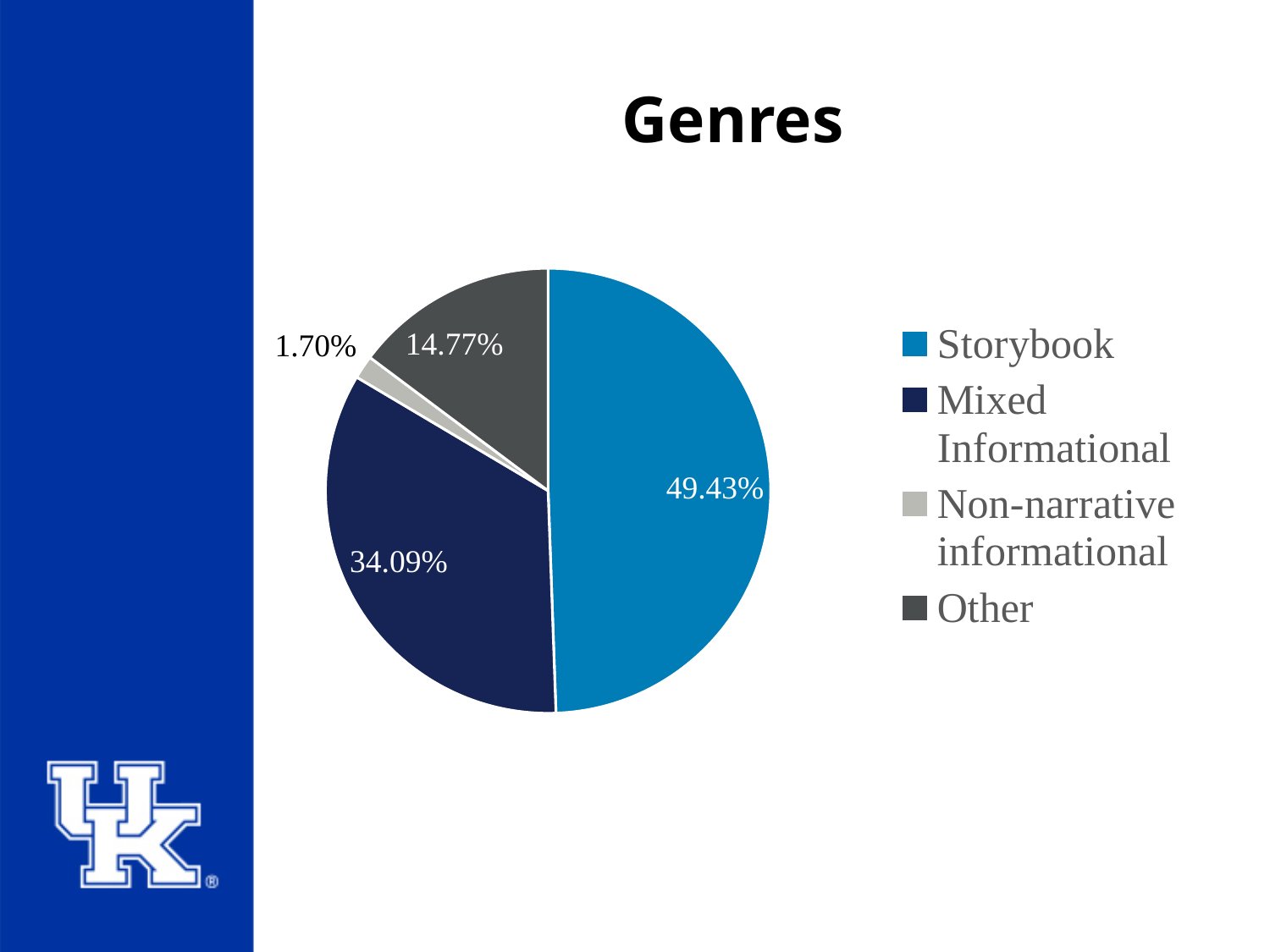
What is the difference in percentage points between the Storybook share and the Mixed Informational share? 15.34 Which genre has the largest share of the pie? Storybook What percentage of the pie does Non-narrative informational account for? 1.70% What percentage of the pie does Storybook account for? 49.43% What colour is the Storybook slice in the pie chart? light blue What percentage of the pie does Other account for? 14.77% What is the title of the chart? Genres Which is larger, the share for Mixed Informational or the share for Other? Mixed Informational What percentage of the pie does Mixed Informational account for? 34.09% How many genre categories are shown in the pie chart? 4 Which genre has the smallest share of the pie? Non-narrative informational What type of chart is shown on the slide? pie chart